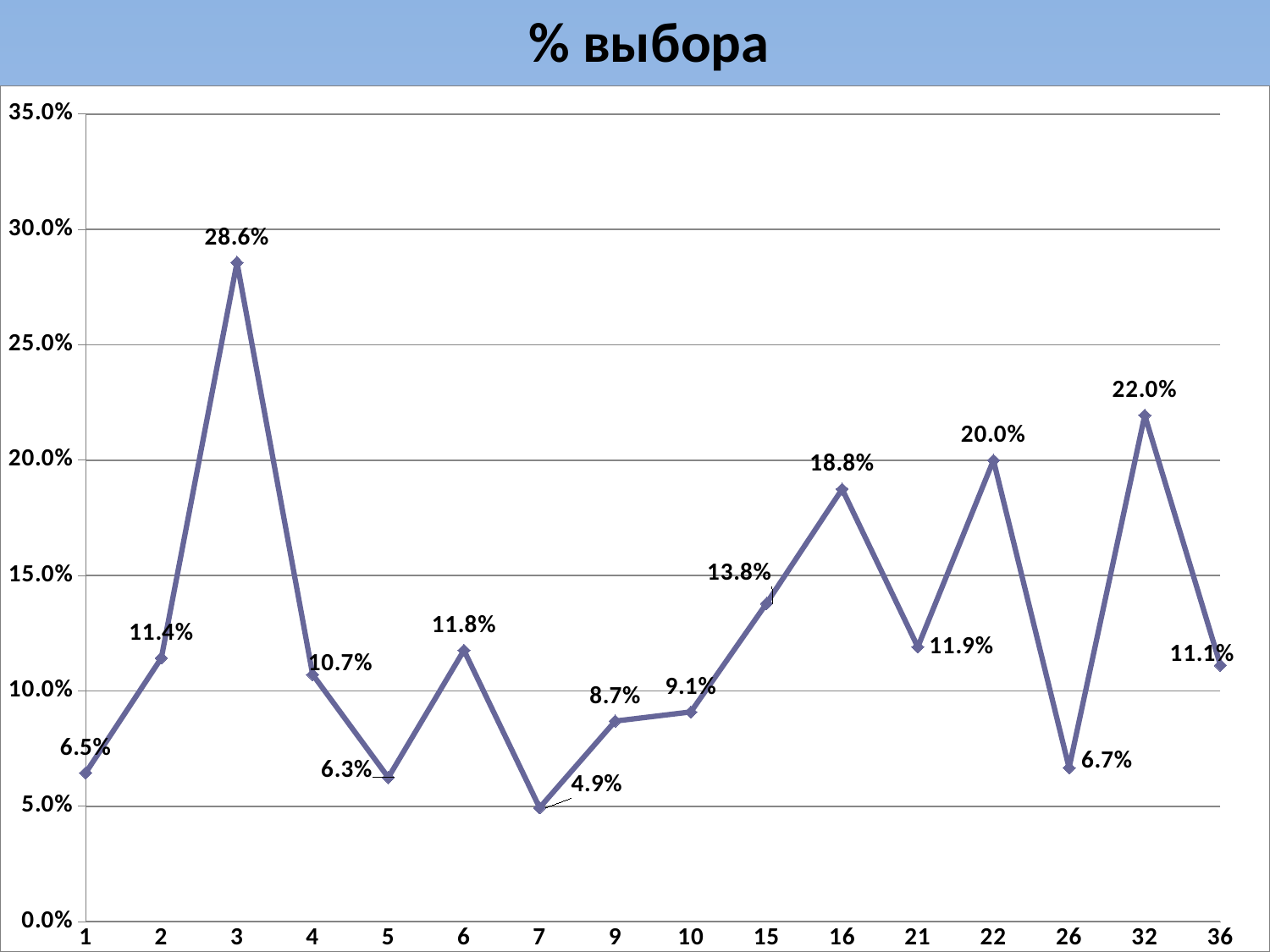
What is the difference between the values for category 32 and category 36? 10.9% Which category has the highest value? 3 How many data points are plotted on the chart? 16 What is the value for category 26? 6.7% What is the title of the chart? % выбора What type of chart is shown on the slide? line chart Which is larger, the value for category 22 or the value for category 16? 22 Is the value for category 15 greater or less than 15.0%? less What is the value for category 3? 28.6% What is the value for category 16? 18.8% Which category has the lowest value? 7 What is the difference between the values for category 3 and category 2? 17.2%